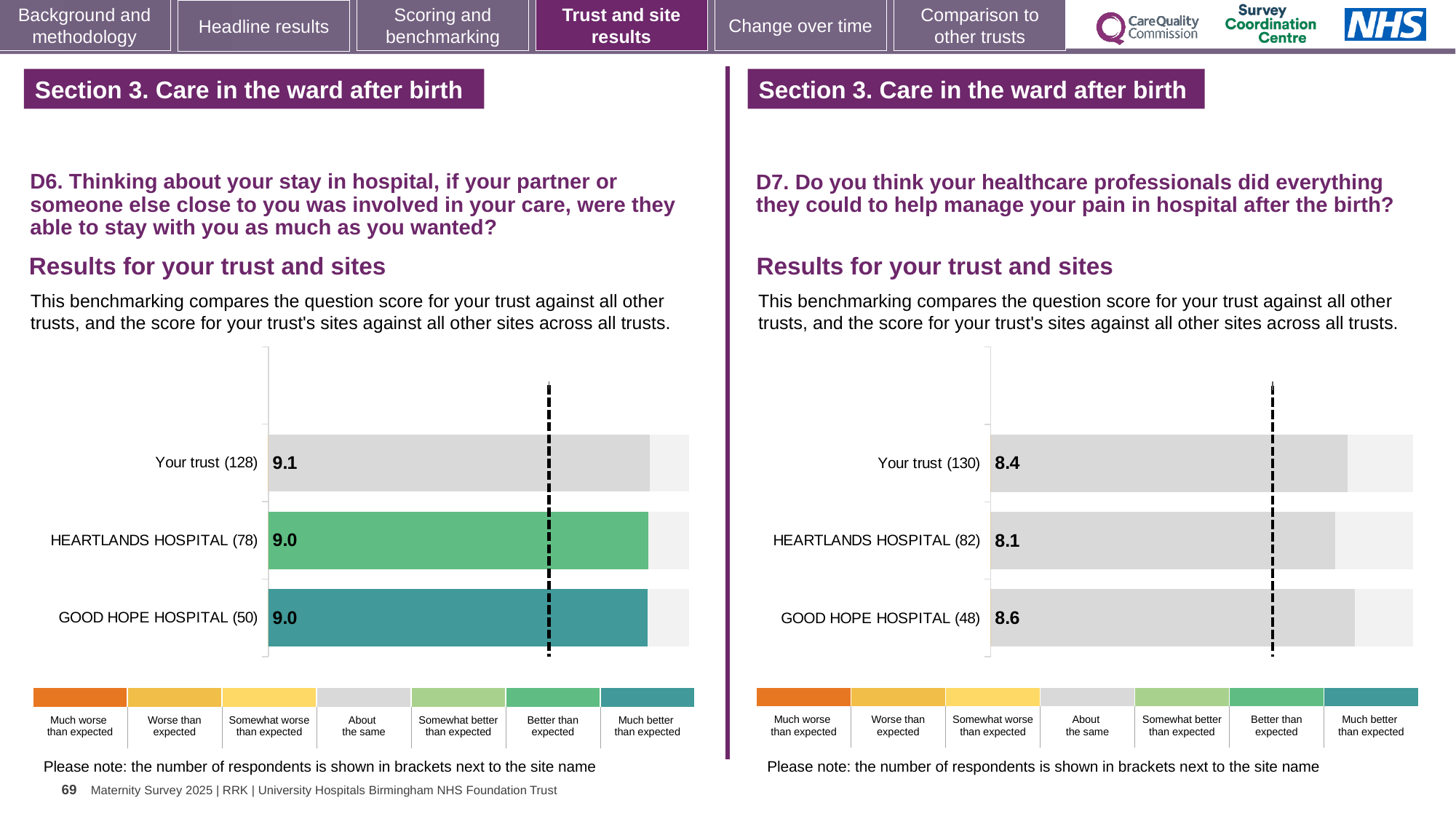
On the D7 chart (right), which is larger: the score for Your trust or the score for HEARTLANDS HOSPITAL? Your trust On the D6 chart (left), what is the score for HEARTLANDS HOSPITAL? 9.0 On the D6 chart (left), what is the difference between the scores for Your trust and GOOD HOPE HOSPITAL? 0.1 How many bars are shown on the D6 chart (left)? 3 On the D6 chart (left), what is the score for Your trust? 9.1 On the D7 chart (right), which site or trust has the lowest score? HEARTLANDS HOSPITAL What kind of chart is the D7 chart (right)? Bar chart On the D7 chart (right), what is the difference between the scores for GOOD HOPE HOSPITAL and HEARTLANDS HOSPITAL? 0.5 On the D7 chart (right), what is the score for HEARTLANDS HOSPITAL? 8.1 On the D7 chart (right), which site or trust has the highest score? GOOD HOPE HOSPITAL On the D7 chart (right), what is the score for GOOD HOPE HOSPITAL? 8.6 On the D6 chart (left), how many respondents are shown in brackets for GOOD HOPE HOSPITAL? 50